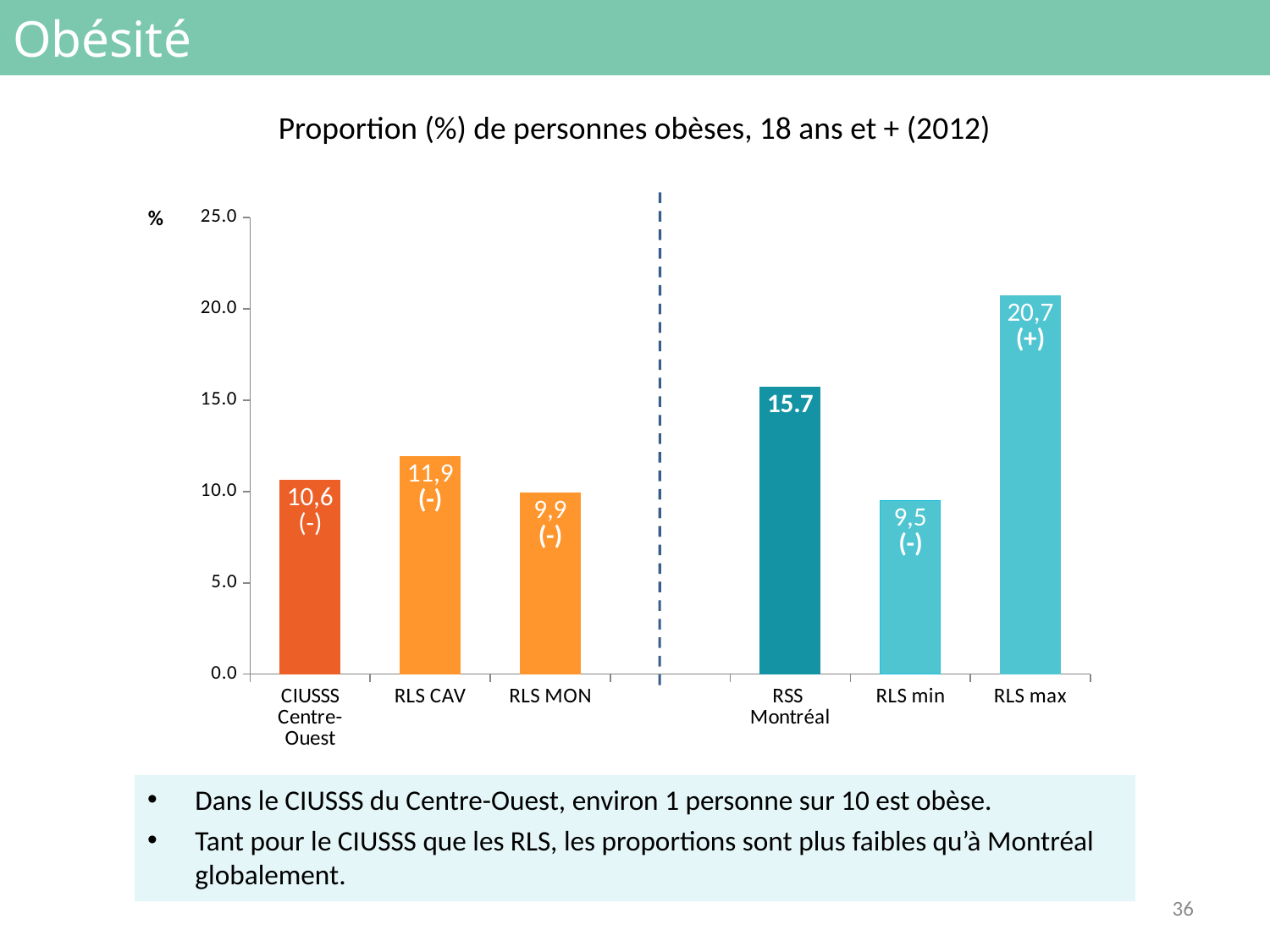
Which is larger, the value for RLS CAV or the value for RLS MON? RLS CAV What is the value shown for RLS MON? 9,9 Which category has the lowest value? RLS min How many categories are shown on the x axis? 6 What is the value shown for RSS Montréal? 15.7 What is the difference between the values for RLS CAV and RLS MON? 2,0 Is the value for RSS Montréal greater or less than 15.0? greater What is the difference between the values for RLS max and CIUSSS Centre-Ouest? 10,1 Which category has the highest value? RLS max What kind of chart is shown on the slide? Bar chart What is the value shown for CIUSSS Centre-Ouest? 10,6 What is the value shown for RLS max? 20,7